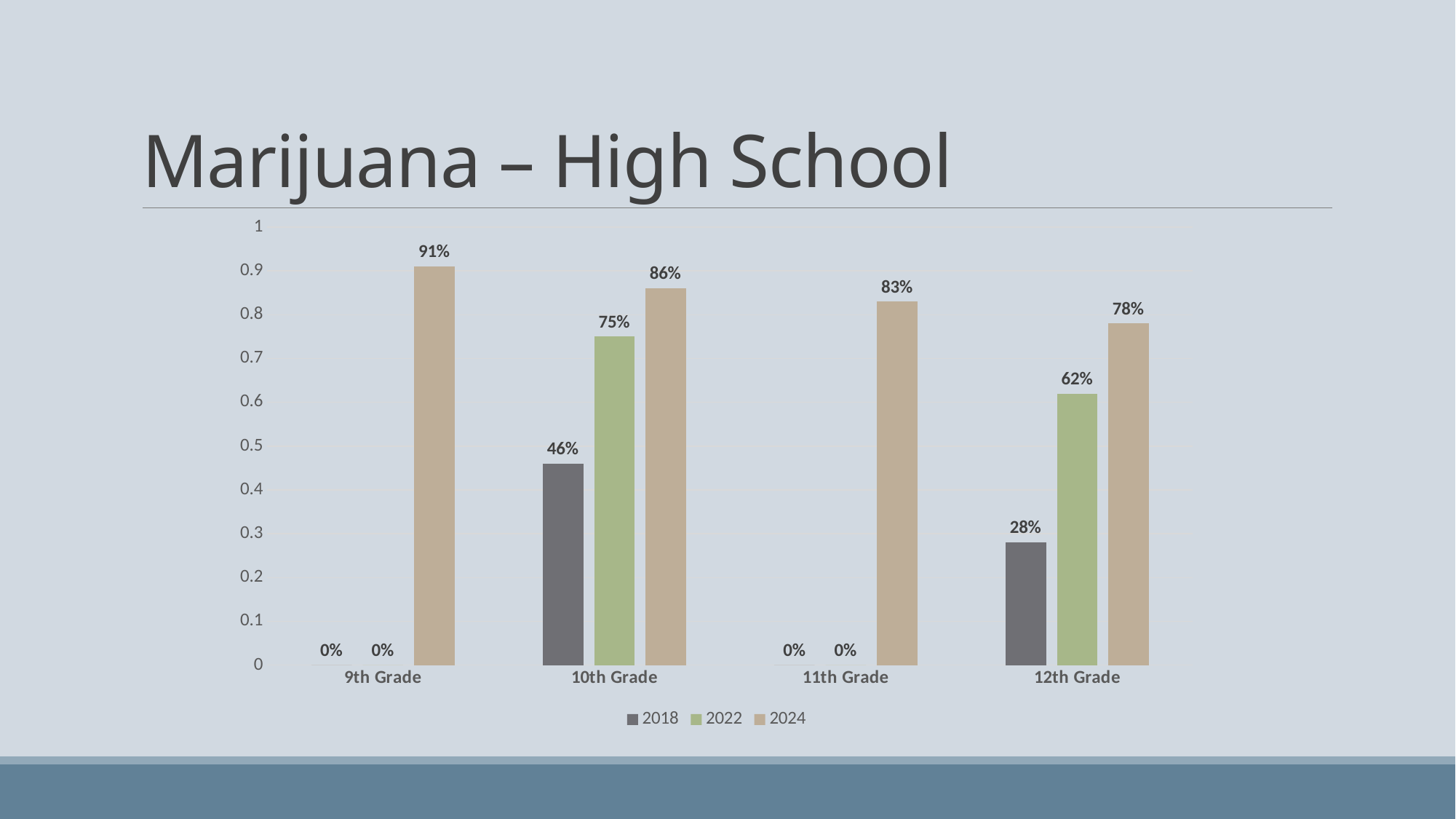
What is the 2024 value for 9th Grade? 91% What is the 2018 value for 10th Grade? 46% What is the title of the slide? Marijuana – High School What is the 2022 value for 12th Grade? 62% How many grade categories are shown on the x axis? 4 How many series does the legend list? 3 What is the 2024 value for 11th Grade? 83% What kind of chart is shown on the slide? Bar chart What is the difference between the 2024 and 2018 values for 12th Grade? 50% Which is larger for 10th Grade, the 2022 value or the 2024 value? 2024 Which grade has the lowest 2024 value? 12th Grade Which grade has the highest 2024 value? 9th Grade